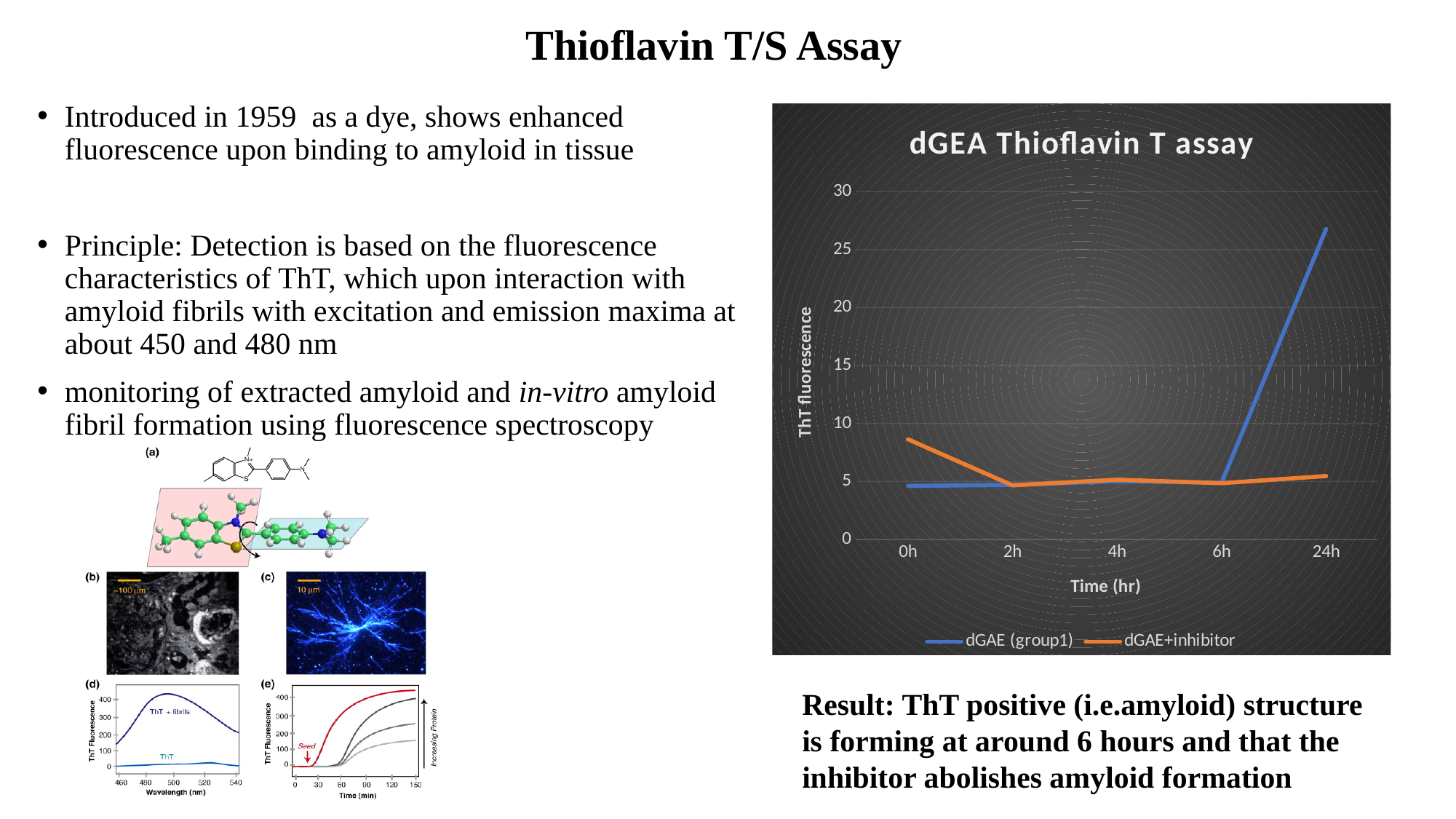
In the "dGEA Thioflavin T assay" chart, how many time points are shown on the x axis? 5 In the "dGEA Thioflavin T assay" chart, at which time point does dGAE (group1) reach its highest ThT fluorescence? 24h What kind of chart is the one titled "dGEA Thioflavin T assay"? line chart In the "dGEA Thioflavin T assay" chart, what is the label of the y axis? ThT fluorescence In the "dGEA Thioflavin T assay" chart, which series has the higher value at 0h, dGAE (group1) or dGAE+inhibitor? dGAE+inhibitor In the "dGEA Thioflavin T assay" chart, is the dGAE (group1) value at 24h greater or less than 25? greater In the "dGEA Thioflavin T assay" chart, is the dGAE+inhibitor value at 0h greater or less than 10? less In the "dGEA Thioflavin T assay" chart, how many series does the legend list? 2 In the "dGEA Thioflavin T assay" chart, which colour is used for the dGAE+inhibitor series? orange In the "dGEA Thioflavin T assay" chart, which series has the higher value at 24h, dGAE (group1) or dGAE+inhibitor? dGAE (group1) In the "dGEA Thioflavin T assay" chart, does the dGAE (group1) line rise or fall between 6h and 24h? rise In the "dGEA Thioflavin T assay" chart, is the dGAE (group1) value at 6h greater or less than 10? less